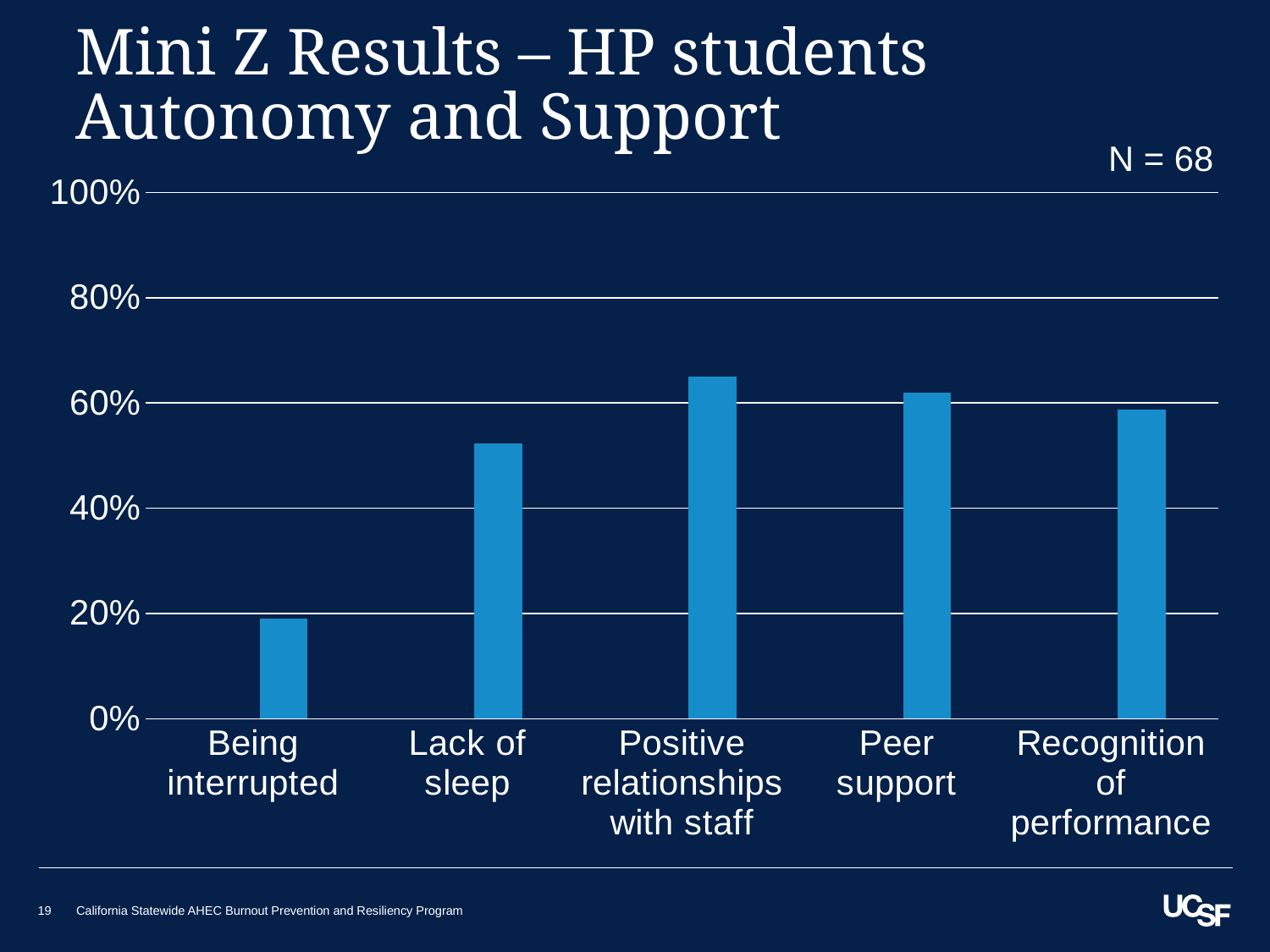
Which is larger, the value for Positive relationships with staff or the value for Lack of sleep? Positive relationships with staff What is the title of the slide containing the chart? Mini Z Results – HP students Autonomy and Support How many categories are plotted on the chart? 5 Is the value for Recognition of performance greater or less than 40%? greater What is the sample size (N) shown on the slide? N = 68 Which is larger, the value for Lack of sleep or the value for Being interrupted? Lack of sleep What kind of chart is shown on the slide? bar chart Which category has the highest value? Positive relationships with staff Is the value for Lack of sleep greater or less than 40%? greater Is the value for Positive relationships with staff greater or less than 60%? greater Which category has the lowest value? Being interrupted